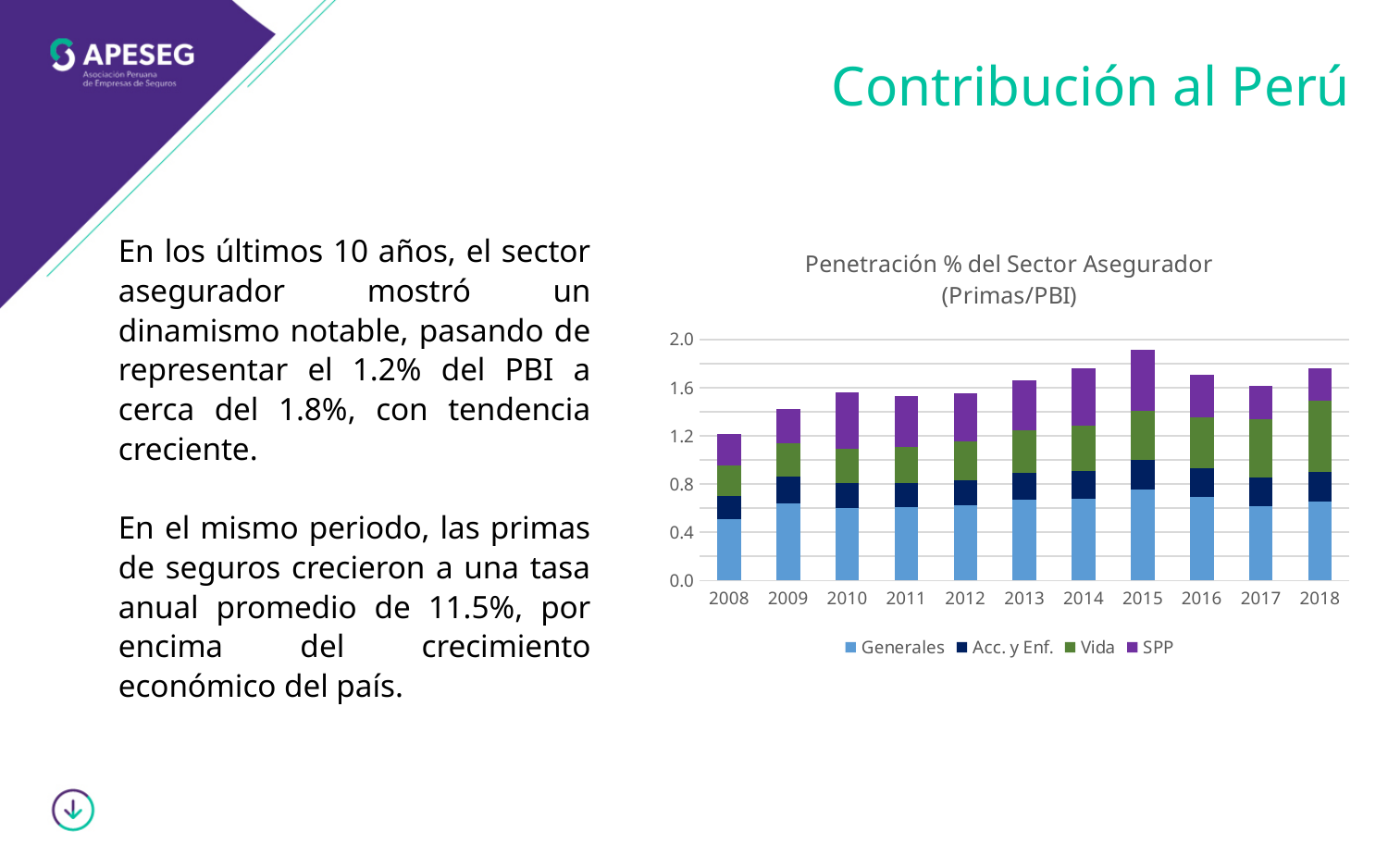
How many years are shown on the x axis of the chart? 11 What kind of chart is shown on the slide? stacked bar chart Is the total stacked bar for 2015 greater or less than 1.6? greater Between 2008 and 2015, do the total bar heights generally rise or fall? rise Is the total stacked bar for 2018 greater or less than 1.6? greater How many series does the chart's legend list? 4 What is the title of the chart? Penetración % del Sector Asegurador (Primas/PBI) Is the total stacked bar for 2008 greater or less than 1.6? less Which year has the shortest stacked bar (lowest total penetration)? 2008 Which year has a taller stacked bar, 2013 or 2009? 2013 Which year has the tallest stacked bar (highest total penetration)? 2015 Which series is shown in purple in the chart's legend? SPP